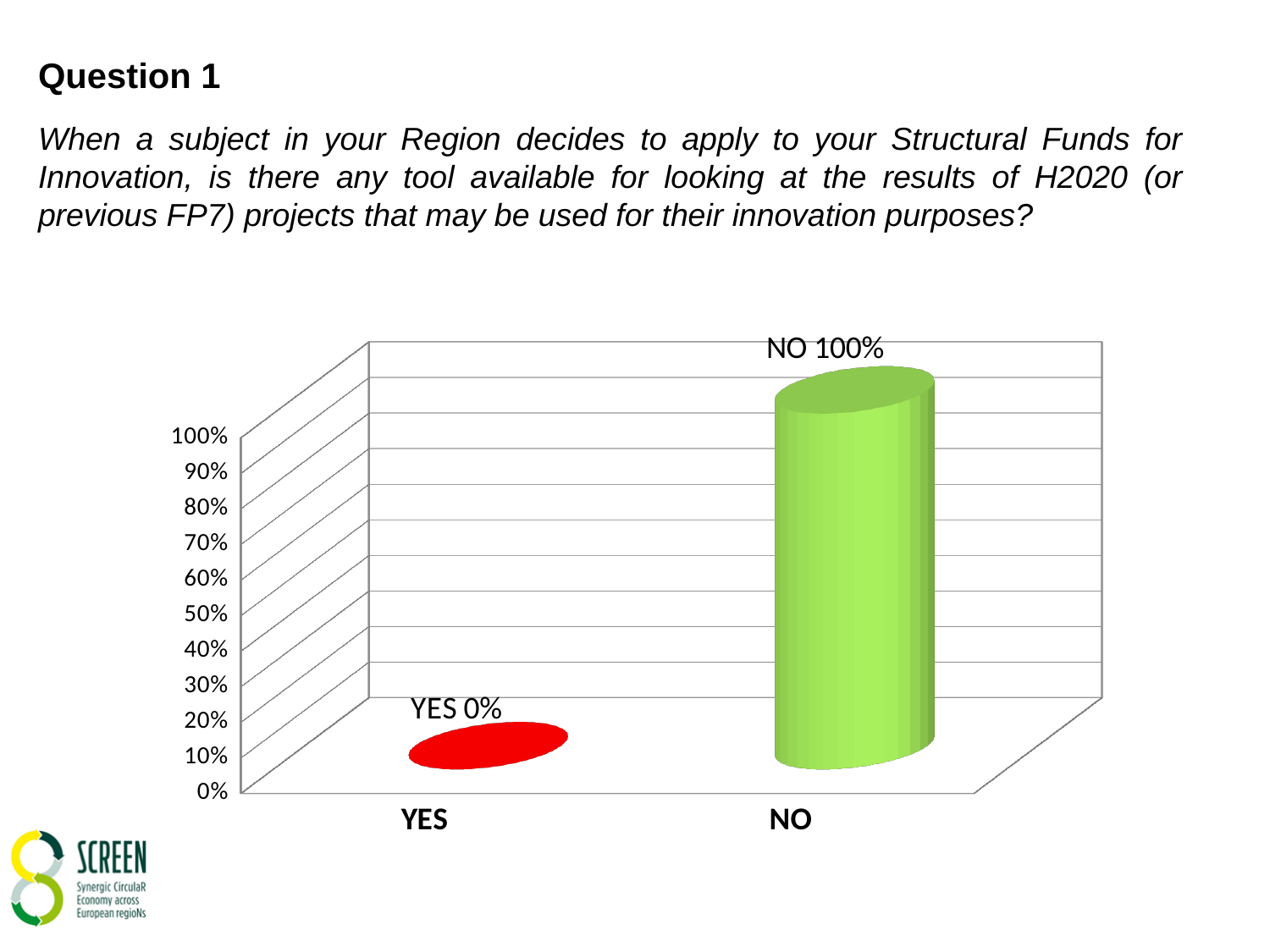
Which category has the lowest value? YES What colour is the bar for NO? green How many categories are shown on the x axis? 2 What is the value for NO? 100% Which category has the highest value? NO What is the highest value shown on the vertical axis? 100% What is the difference between the values for NO and YES? 100% Which is larger, the value for YES or the value for NO? NO Is the value for NO greater or less than 50%? greater What kind of chart is shown on the slide? bar chart What is the value for YES? 0%